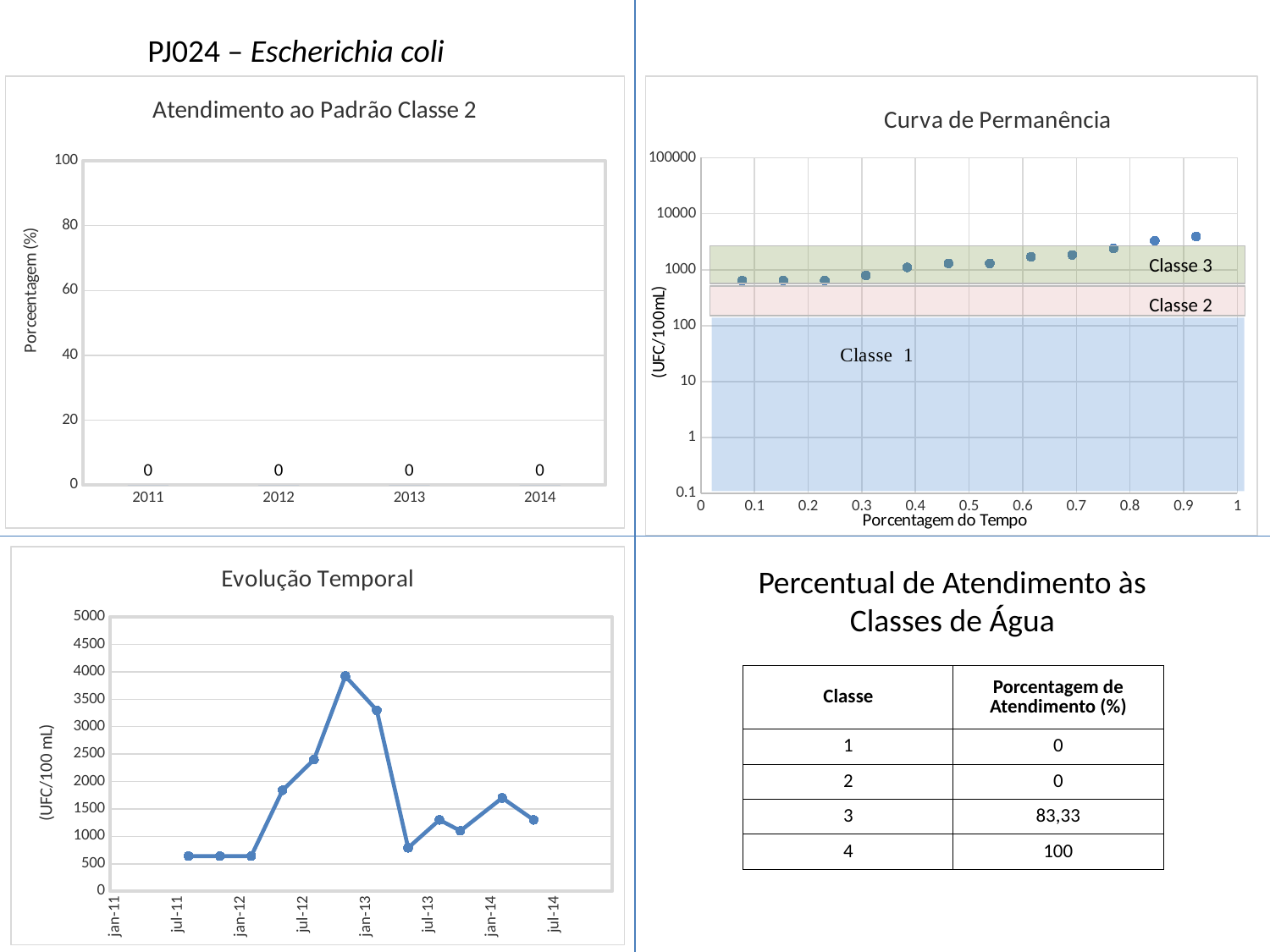
In the 'Curva de Permanência' chart, do the values rise or fall as the percentage of time increases? rise In the 'Atendimento ao Padrão Classe 2' chart, how many years are shown on the x axis? 4 What kind of chart is 'Curva de Permanência'? scatter chart In the 'Evolução Temporal' chart, is the highest point greater or less than 3500? greater What kind of chart is 'Evolução Temporal'? line chart In the 'Atendimento ao Padrão Classe 2' chart, what is the value for 2014? 0 In the 'Atendimento ao Padrão Classe 2' chart, what is the value for 2012? 0 What is the x-axis title of the 'Curva de Permanência' chart? Porcentagem do Tempo In the 'Curva de Permanência' chart, is the value of the leftmost point (near 0.08) greater or less than 1000? less In the 'Curva de Permanência' chart, how many data points are plotted? 12 In the 'Curva de Permanência' chart, is the value of the rightmost point (near 0.92) greater or less than 1000? greater